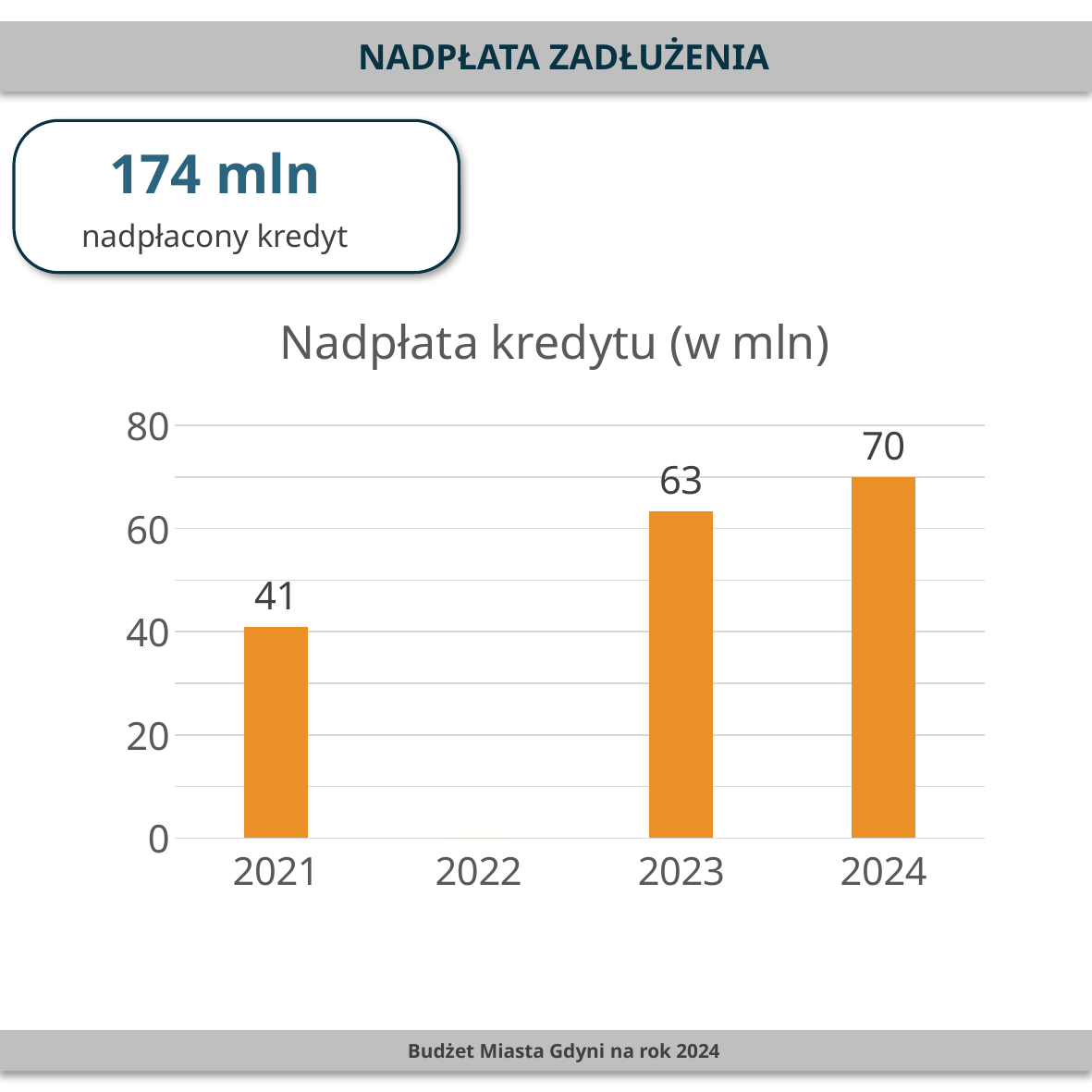
Which is larger in the chart 'Nadpłata kredytu (w mln)': the value for 2023 or the value for 2024? 2024 Is the value for 2021 in the chart 'Nadpłata kredytu (w mln)' greater or less than 60? less What is the difference between the values for 2023 and 2021 in the chart 'Nadpłata kredytu (w mln)'? 22 What kind of chart is 'Nadpłata kredytu (w mln)'? bar chart What is the value for 2023 in the chart 'Nadpłata kredytu (w mln)'? 63 What is the value for 2024 in the chart 'Nadpłata kredytu (w mln)'? 70 Which year has the highest value in the chart 'Nadpłata kredytu (w mln)'? 2024 What is the title of the chart on the slide? Nadpłata kredytu (w mln) How many years are shown on the x axis of the chart 'Nadpłata kredytu (w mln)'? 4 What is the value for 2021 in the chart 'Nadpłata kredytu (w mln)'? 41 What is the difference between the values for 2024 and 2021 in the chart 'Nadpłata kredytu (w mln)'? 29 Among the years with a labelled bar, which year has the lowest value in the chart 'Nadpłata kredytu (w mln)'? 2021